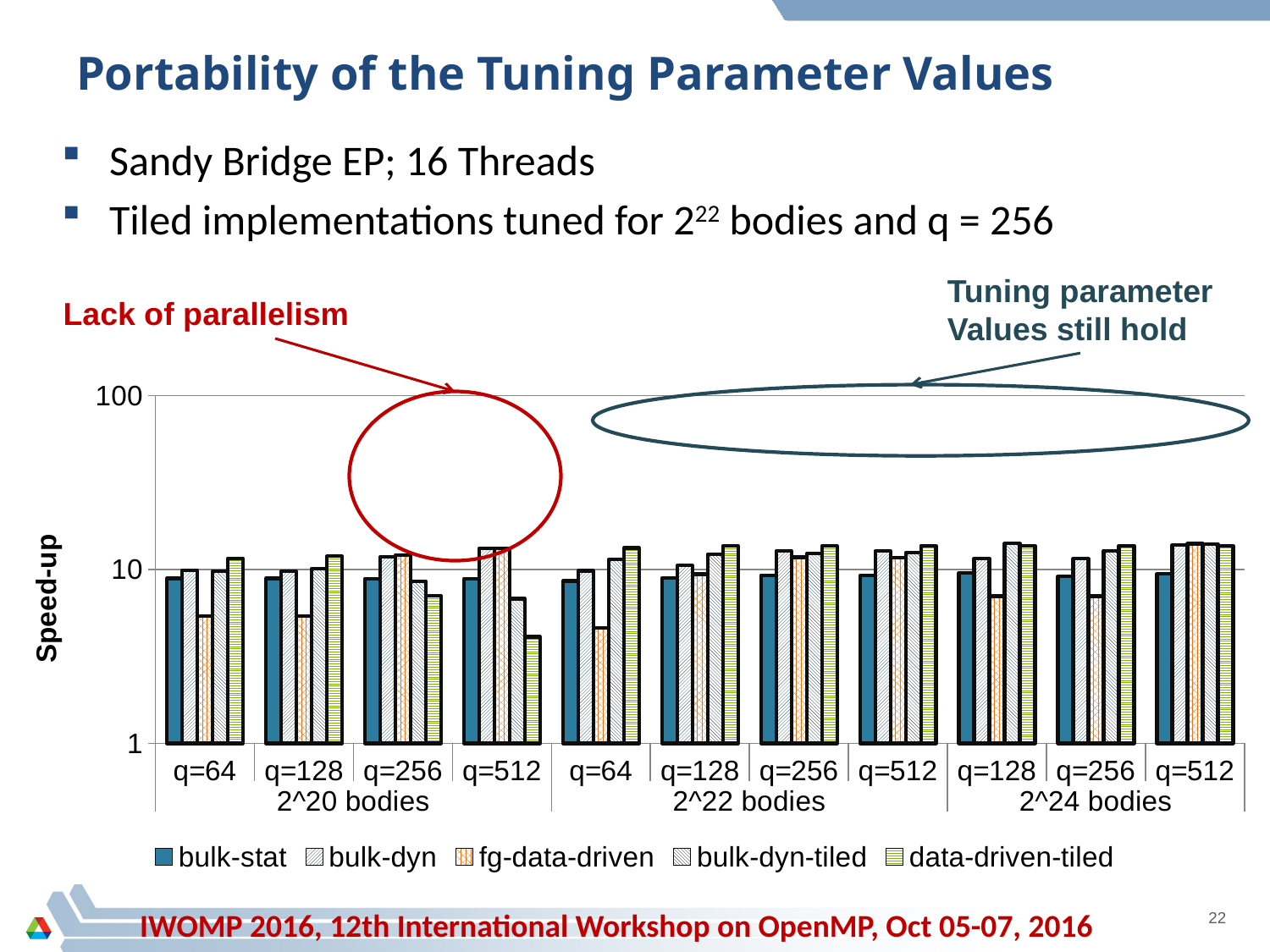
How many series does the legend list? 5 Is the speed-up for data-driven-tiled at q=512 with 2^20 bodies greater or less than 10? less Is the speed-up for data-driven-tiled at q=512 with 2^22 bodies greater or less than 10? greater How many q-value categories are shown along the x axis in total? 11 How many body-size groups (e.g. 2^20 bodies) are shown on the x axis? 3 Within the q=512 group for 2^20 bodies, which series has the lowest speed-up? data-driven-tiled What is the label of the y axis? Speed-up Is the speed-up for fg-data-driven at q=64 with 2^22 bodies greater or less than 10? less What kind of chart is shown on the slide? bar chart Which series is listed last in the legend? data-driven-tiled At q=512 with 2^20 bodies, which is larger: the speed-up for fg-data-driven or for data-driven-tiled? fg-data-driven